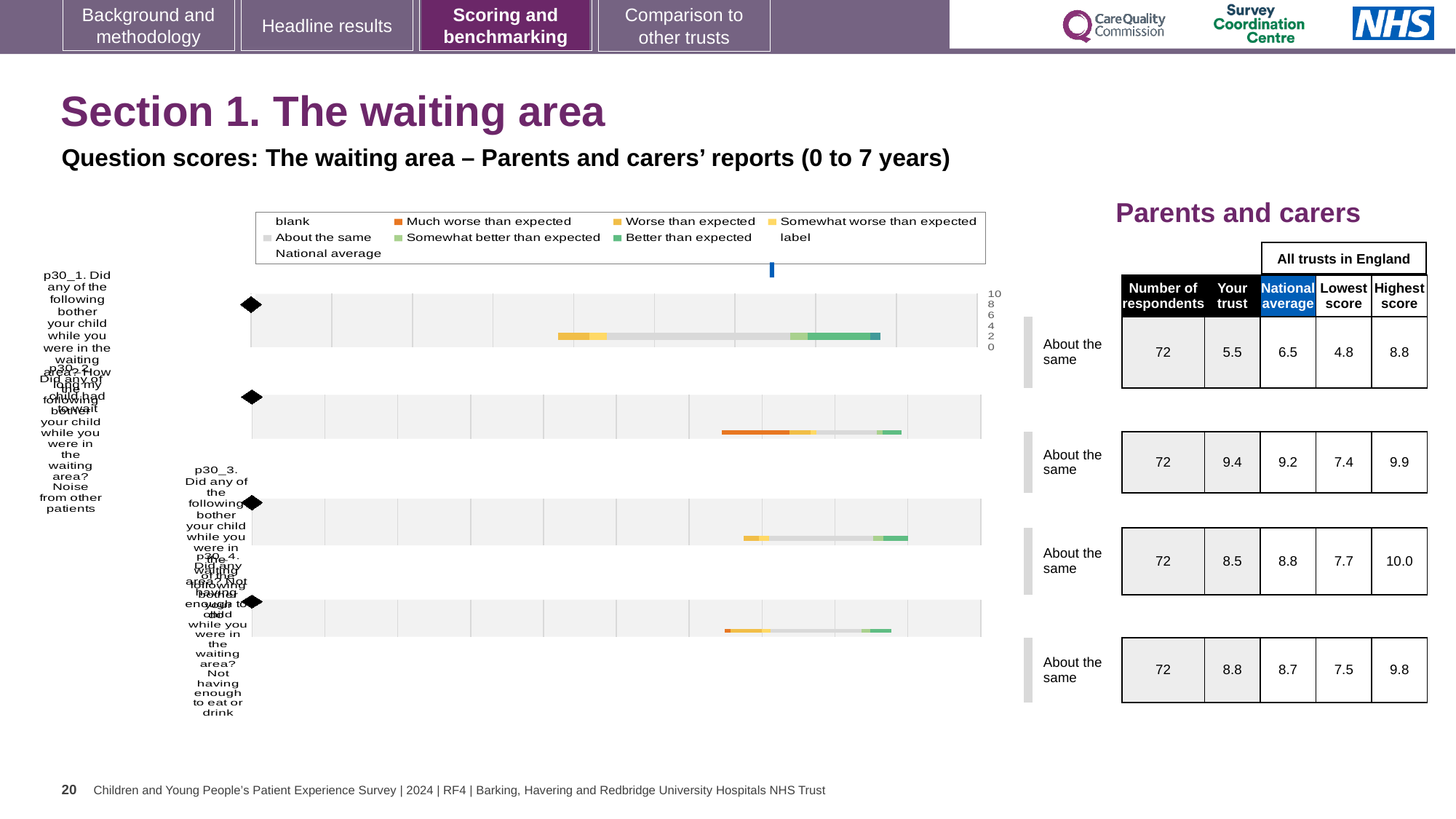
How many entries does the chart legend list? 9 What kind of chart is shown on the slide? bar chart Which legend entry is shown in orange? Much worse than expected What benchmark category is shown next to the bar for p30_1? About the same What is the highest value shown on the chart's axis? 10 How many question bars are plotted in the chart? 4 What benchmark category is shown next to the bar for p30_4? About the same